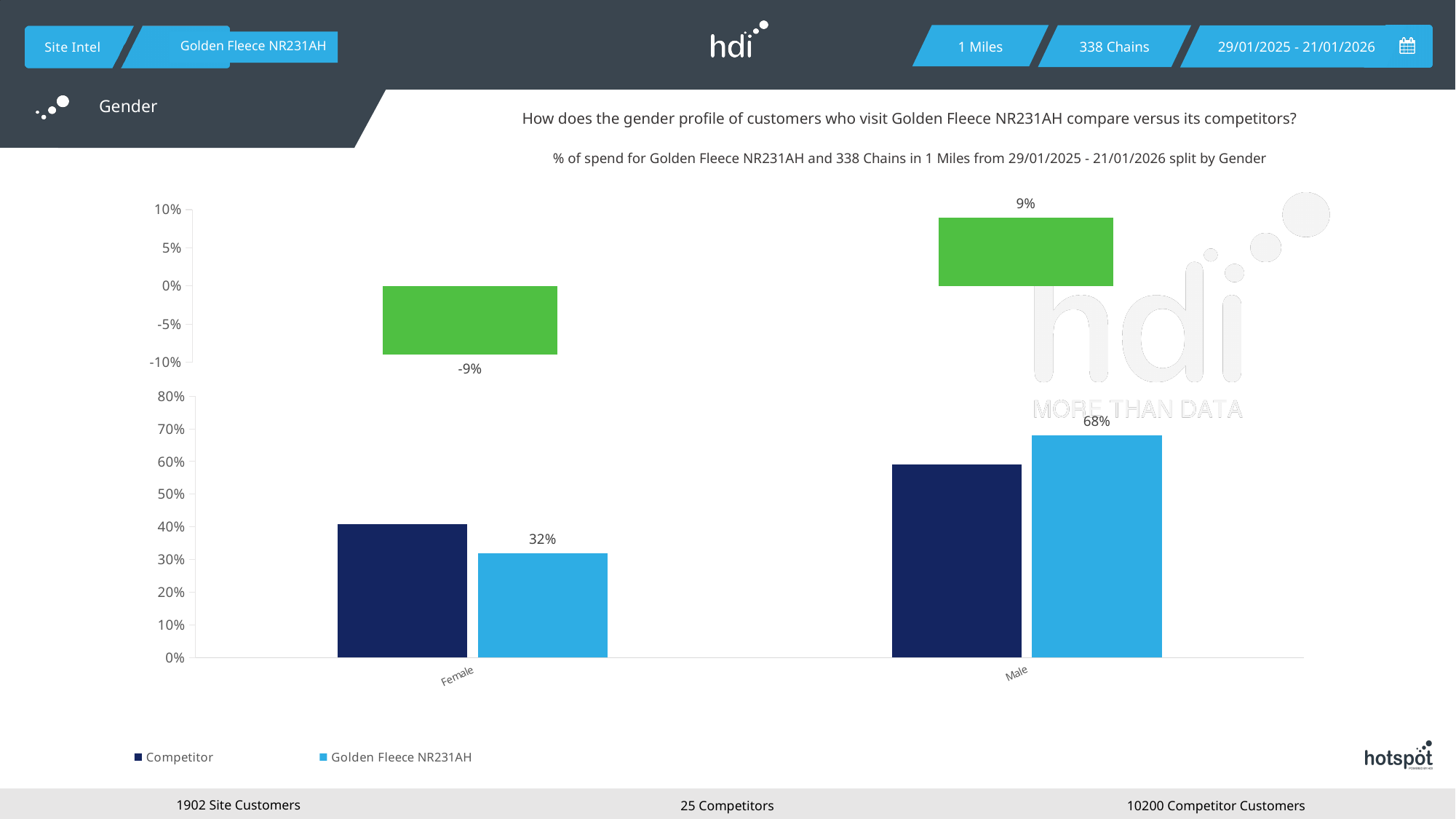
In the bottom chart, is the Competitor value for Female greater or less than 50%? less In the bottom chart, which is larger for Male: Competitor or Golden Fleece NR231AH? Golden Fleece NR231AH In the bottom chart, what is the value for Golden Fleece NR231AH for Male? 68% In the top chart, what is the value shown for Male? 9% In the bottom chart, which is larger for Female: Competitor or Golden Fleece NR231AH? Competitor In the bottom chart, what is the difference between the Golden Fleece NR231AH values for Male and Female? 36% What kind of chart is the bottom chart? Bar chart In the bottom chart, what is the value for Golden Fleece NR231AH for Female? 32% In the bottom chart, is the Competitor value for Male greater or less than 50%? greater How many categories are shown on the x axis of the bottom chart? 2 In the top chart, what is the value shown for Female? -9% How many series does the legend of the bottom chart list? 2